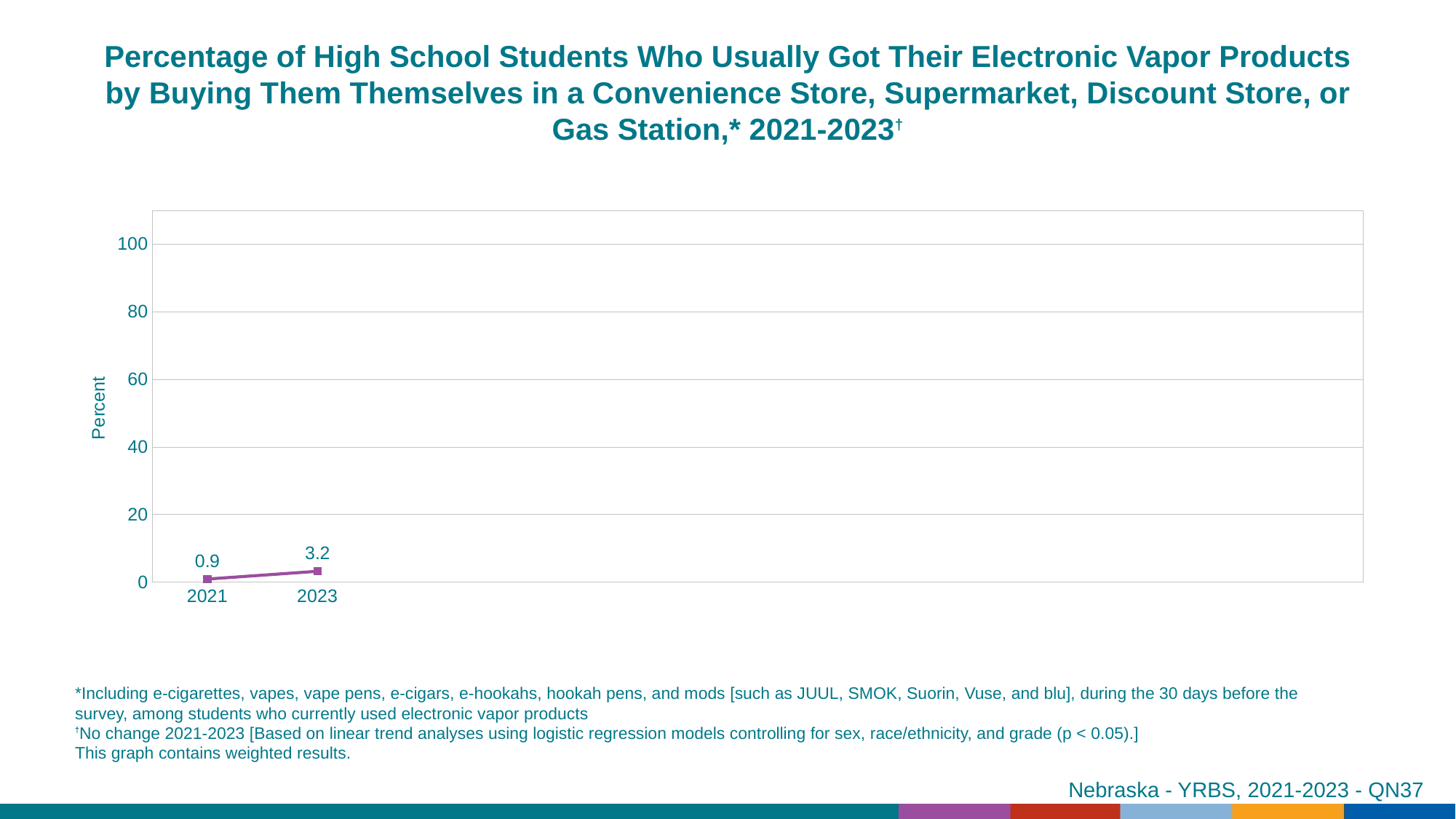
What is the value for 2023? 3.2 What is the value for 2021? 0.9 What is the label on the y axis? Percent Do the values rise or fall from 2021 to 2023? rise Is the value for 2023 greater or less than 20? less Which year has the highest value? 2023 What is the maximum value shown on the y axis? 100 How many data points are plotted on the chart? 2 Which year has the lowest value? 2021 What kind of chart is shown on the slide? line chart Which is larger, the value for 2021 or the value for 2023? 2023 What is the difference between the 2023 and 2021 values? 2.3